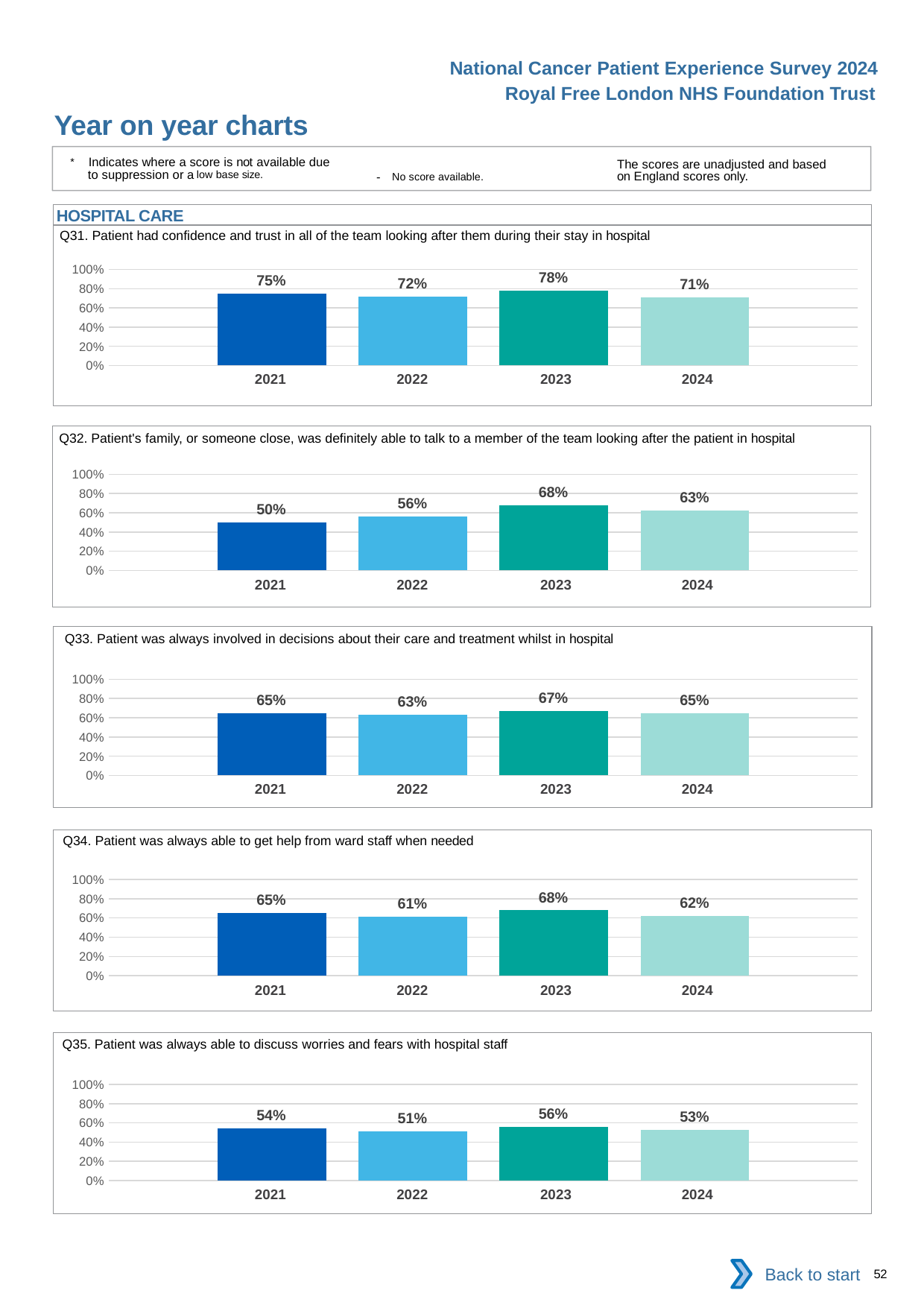
What is the section heading above the Q31 chart? HOSPITAL CARE In the Q32 chart (patient's family was definitely able to talk to a member of the team), what is the difference between the 2023 and 2021 values? 18 percentage points In the Q35 chart (patient was always able to discuss worries and fears), is the value for 2022 greater or less than 60%? less In the Q32 chart (patient's family was definitely able to talk to a member of the team), which year has the lowest value? 2021 In the Q34 chart (patient was always able to get help from ward staff), is the value for 2021 larger or smaller than the value for 2024? larger In the Q33 chart (patient was always involved in decisions about their care), what is the value for 2022? 63% In the Q31 chart (patient had confidence and trust in all of the team), what is the value for 2023? 78% In the Q31 chart (patient had confidence and trust in all of the team), what is the difference between the 2021 and 2022 values? 3 percentage points In the Q34 chart (patient was always able to get help from ward staff), which year has the highest value? 2023 In the Q35 chart (patient was always able to discuss worries and fears), what is the value for 2024? 53% What kind of chart is used for Q33 (patient was always involved in decisions about their care)? bar chart How many years are shown on the x axis of the Q31 chart? 4